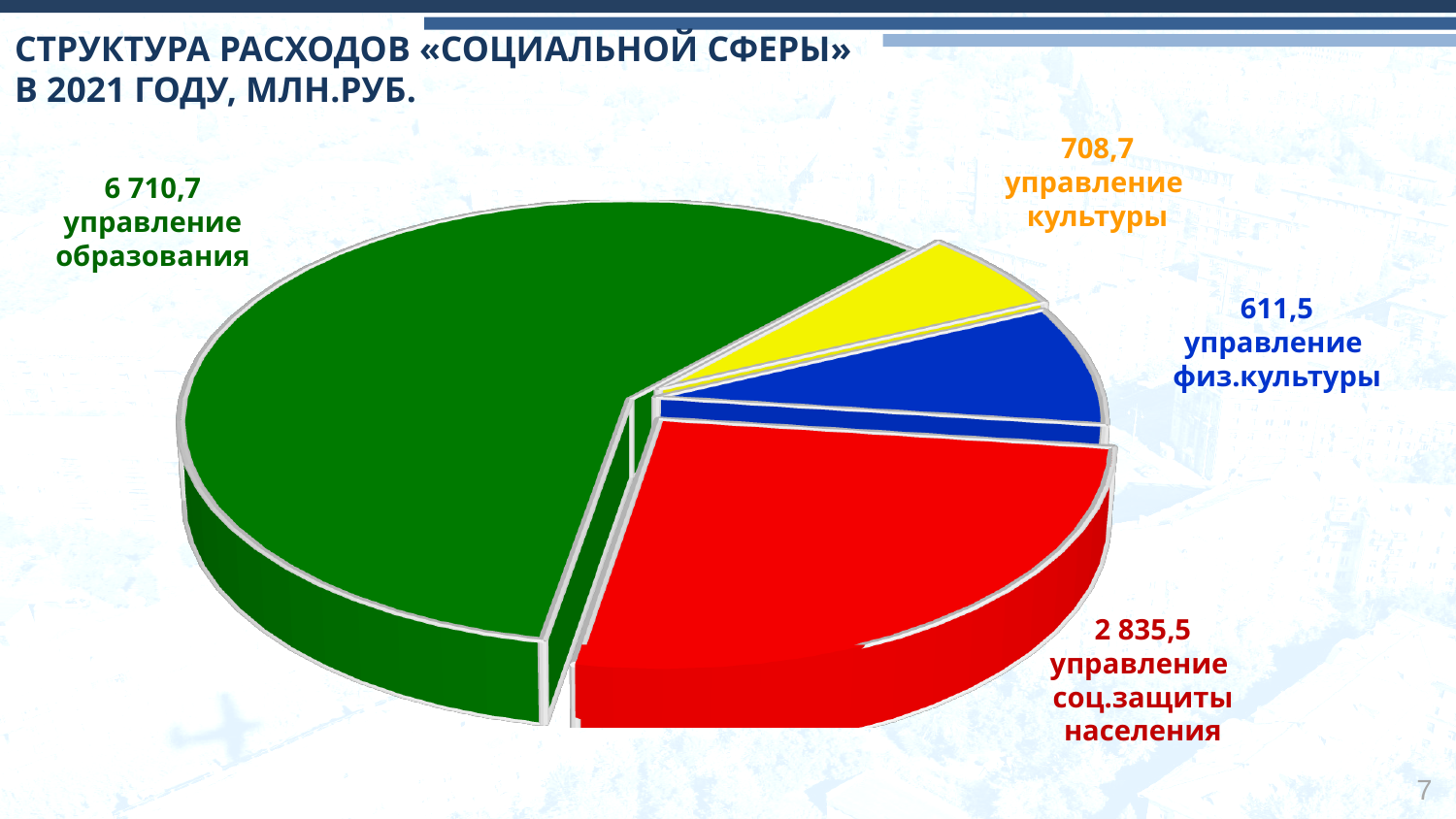
What colour is the slice for управление культуры? yellow What is the value for управление образования? 6 710,7 What is the difference between the values for управление культуры and управление физ.культуры? 97,2 What is the difference between the values for управление образования and управление соц.защиты населения? 3 875,2 What is the value for управление культуры? 708,7 Which category has the smallest slice of the pie? управление физ.культуры What is the value for управление соц.защиты населения? 2 835,5 Which is larger, the value for управление соц.защиты населения or the value for управление культуры? управление соц.защиты населения How many slices does the pie chart have? 4 What is the value for управление физ.культуры? 611,5 Which category has the largest slice of the pie? управление образования What kind of chart is shown on the slide? pie chart